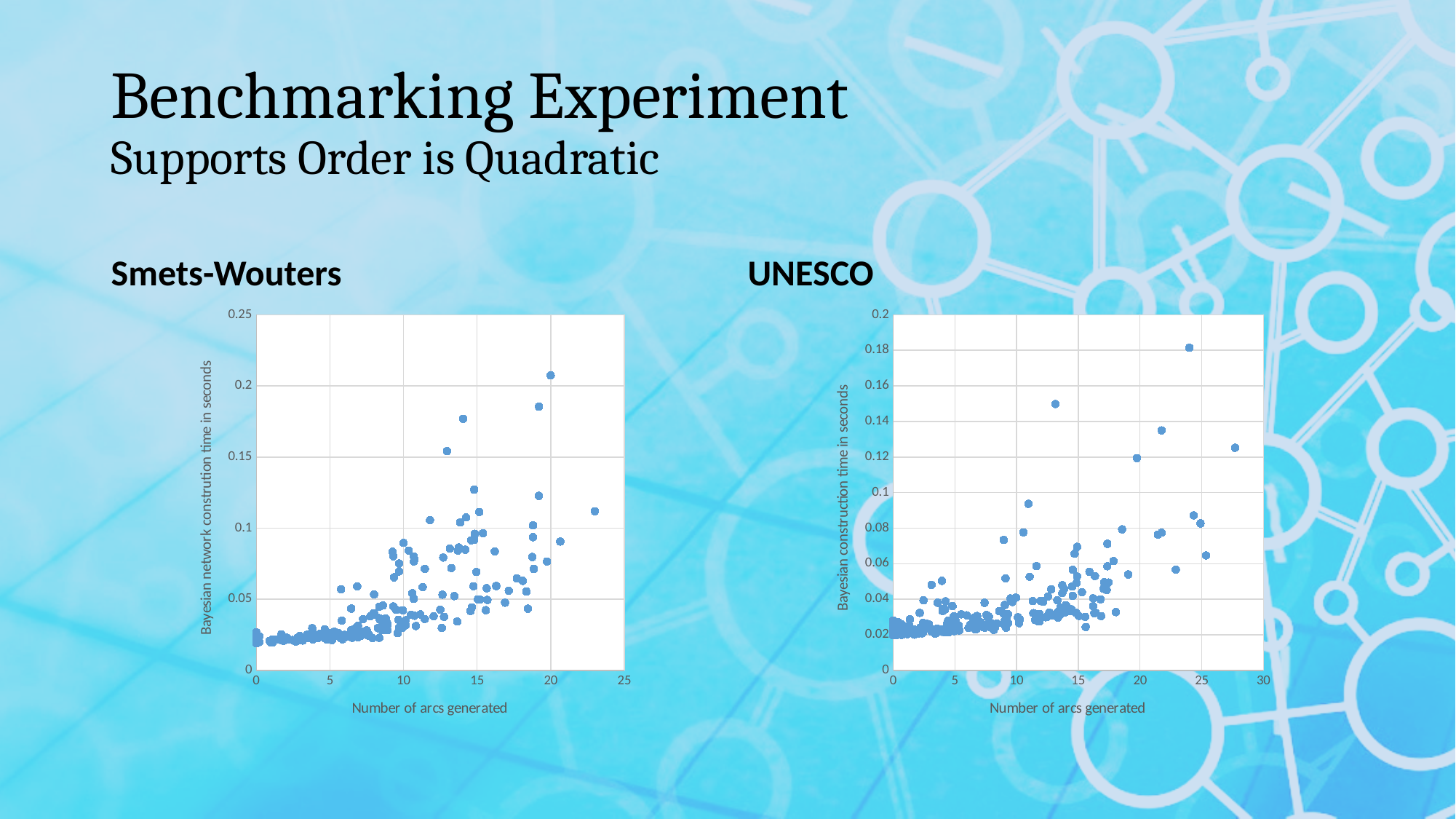
In the UNESCO chart, do the construction times generally rise or fall as the number of arcs generated increases? rise In the Smets-Wouters chart, is the highest plotted construction time greater or less than 0.2 seconds? greater What is the maximum value shown on the x axis of the UNESCO chart? 30 In the Smets-Wouters chart, what is the label of the x axis? Number of arcs generated In the UNESCO chart, is the highest plotted construction time greater or less than 0.16 seconds? greater What kind of chart is the UNESCO chart? scatter chart In the Smets-Wouters chart, are the construction times for fewer than 5 arcs generated greater or less than 0.05 seconds? less What is the maximum value shown on the y axis of the Smets-Wouters chart? 0.25 In the Smets-Wouters chart, do the construction times generally rise or fall as the number of arcs generated increases? rise What kind of chart is the Smets-Wouters chart? scatter chart